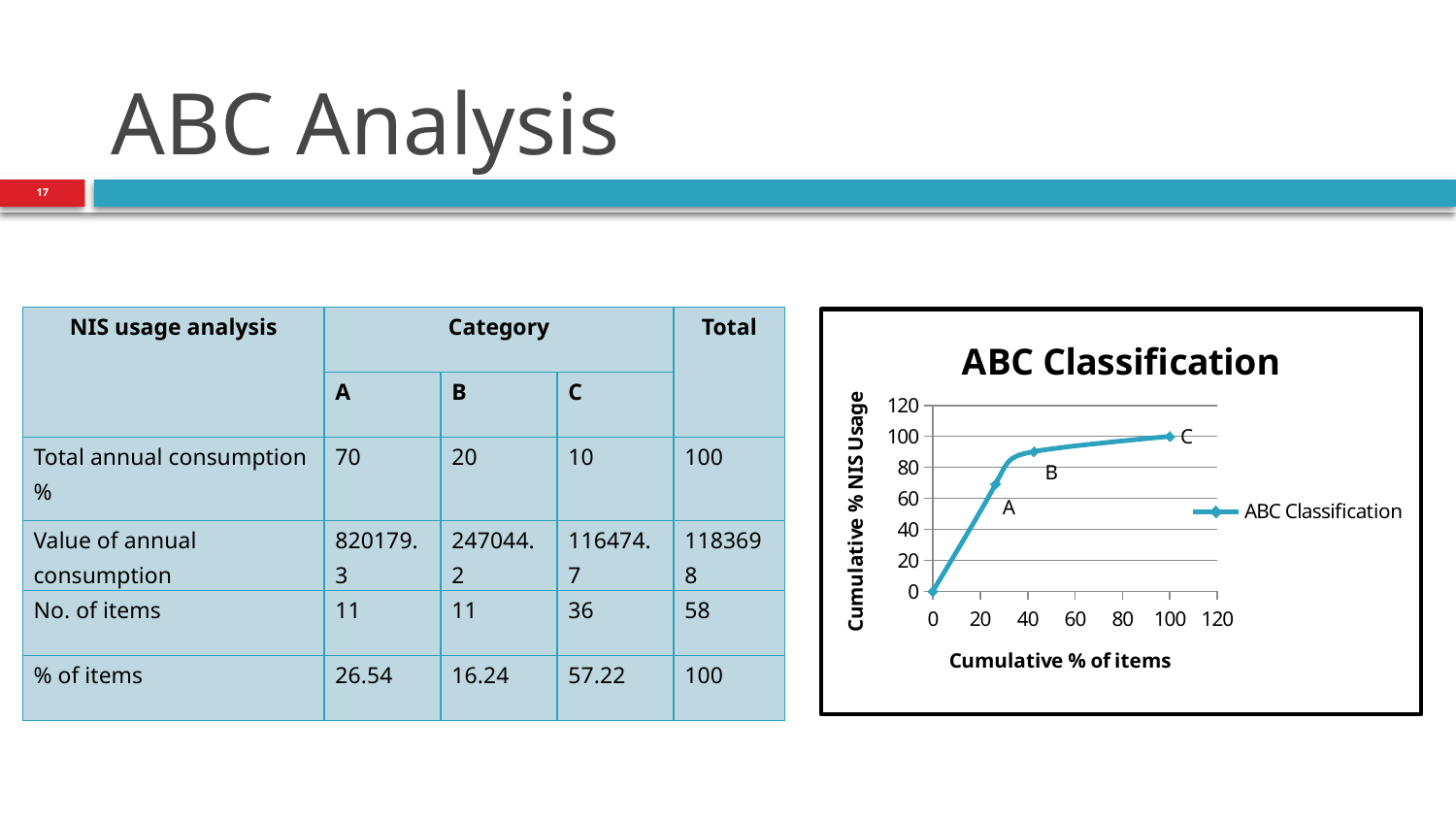
In the ABC Classification chart, is the cumulative % NIS usage at point A greater or less than 60? greater In the ABC Classification chart, which labeled point has a higher cumulative % NIS usage, A or C? C What is the title of the chart on the slide? ABC Classification In the ABC Classification chart, is the cumulative % of items at point B greater or less than 60? less What entry is shown in the legend of the ABC Classification chart? ABC Classification In the ABC Classification chart, is the cumulative % NIS usage at point B greater or less than 80? greater In the ABC Classification chart, which labeled point has the highest cumulative % NIS usage? C How many series does the legend of the ABC Classification chart list? 1 What kind of chart is the ABC Classification chart? line chart In the ABC Classification chart, do the values rise or fall as cumulative % of items increases? rise